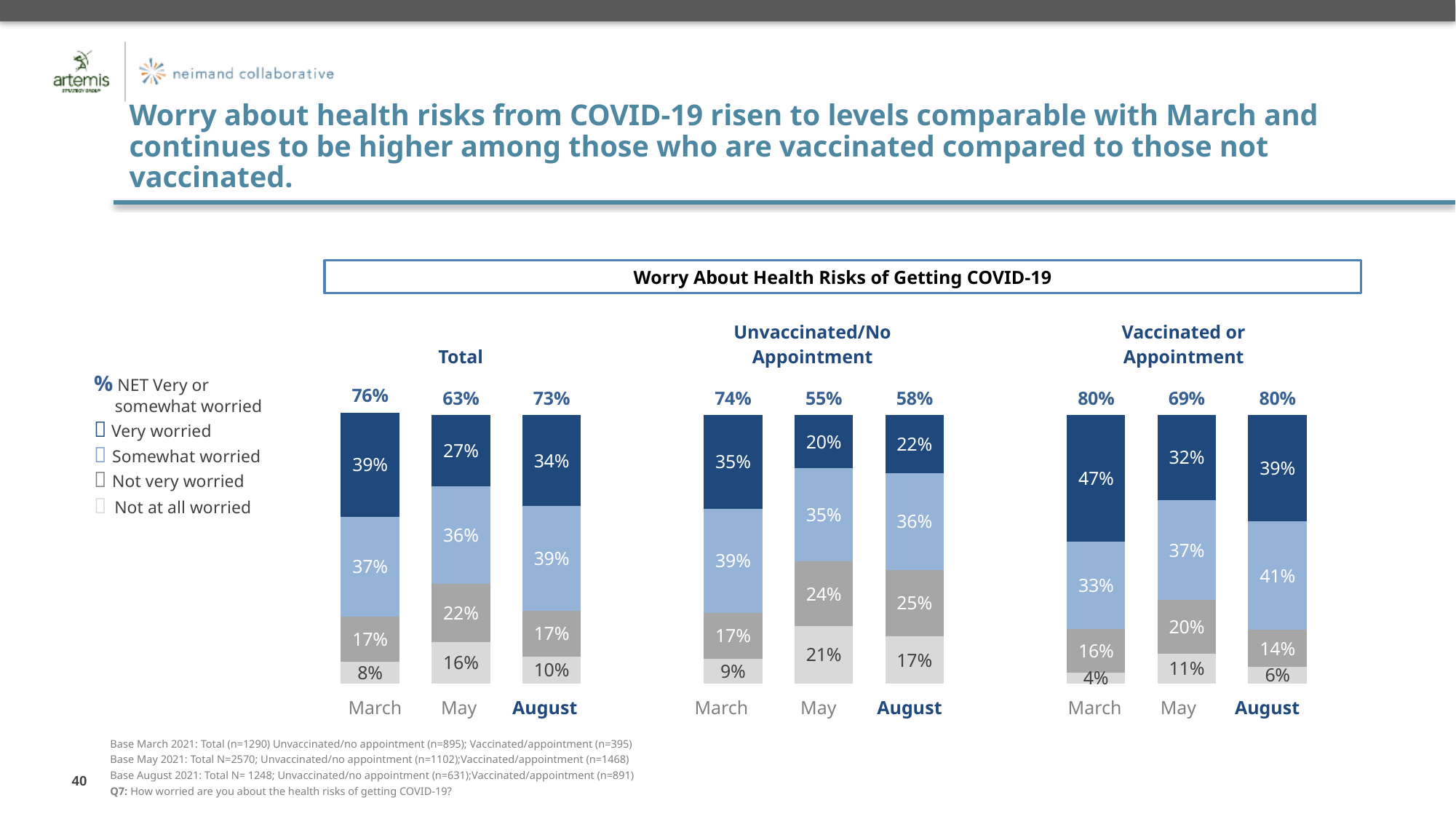
In the Vaccinated or Appointment chart, is the very worried share larger in March or in August? March In the Vaccinated or Appointment chart, what percentage were not at all worried in March? 4% In the Unvaccinated/No Appointment chart, which month has the highest NET very or somewhat worried figure? March How many worry categories does the legend list below the NET line? 4 In the Total chart, what percentage were very worried in March? 39% In the Unvaccinated/No Appointment chart, what is the NET very or somewhat worried figure for May? 55% In the Total chart, what is the combined share of very worried and somewhat worried in August? 73% What kind of chart is used to show the worry levels? Stacked bar chart In the Total chart, what is the difference between the NET very or somewhat worried figures for March and May? 13 percentage points In the Unvaccinated/No Appointment chart, what is the difference between the somewhat worried shares in May and March? 4 percentage points How many months are shown in each chart? 3 In the Vaccinated or Appointment chart, which month has the lowest NET very or somewhat worried figure? May